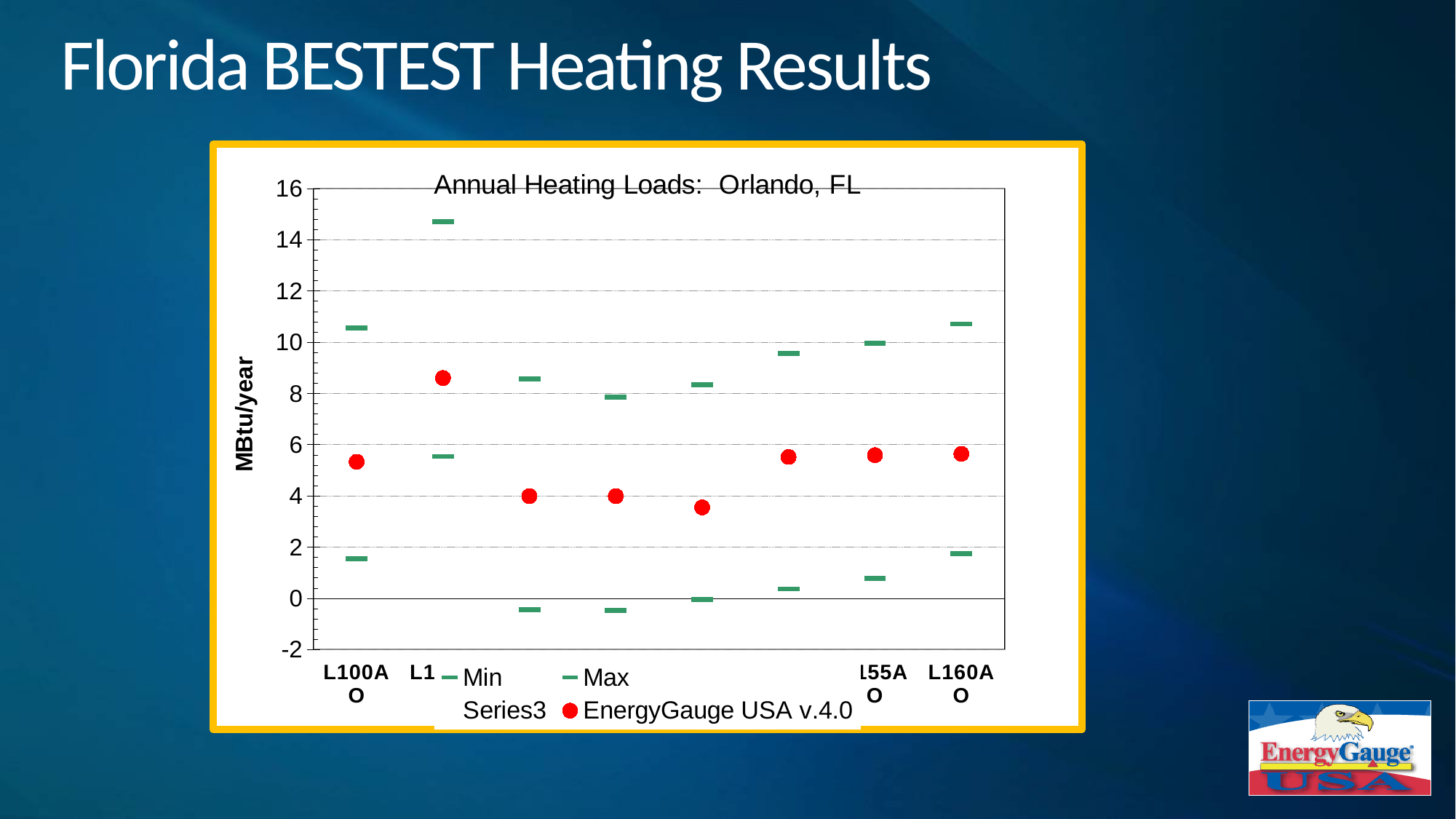
Is the highest Max marker on the chart greater or less than 14? greater Is the Max value for L100AO greater or less than 10? greater How many series does the legend list? 4 Is the Min value for L100AO greater or less than 2? less What is the y-axis label of the chart? MBtu/year How many categories (test cases) are plotted along the x axis? 8 What is the title of the chart? Annual Heating Loads: Orlando, FL For L100AO, which is larger: the Max value or the EnergyGauge USA v.4.0 value? Max